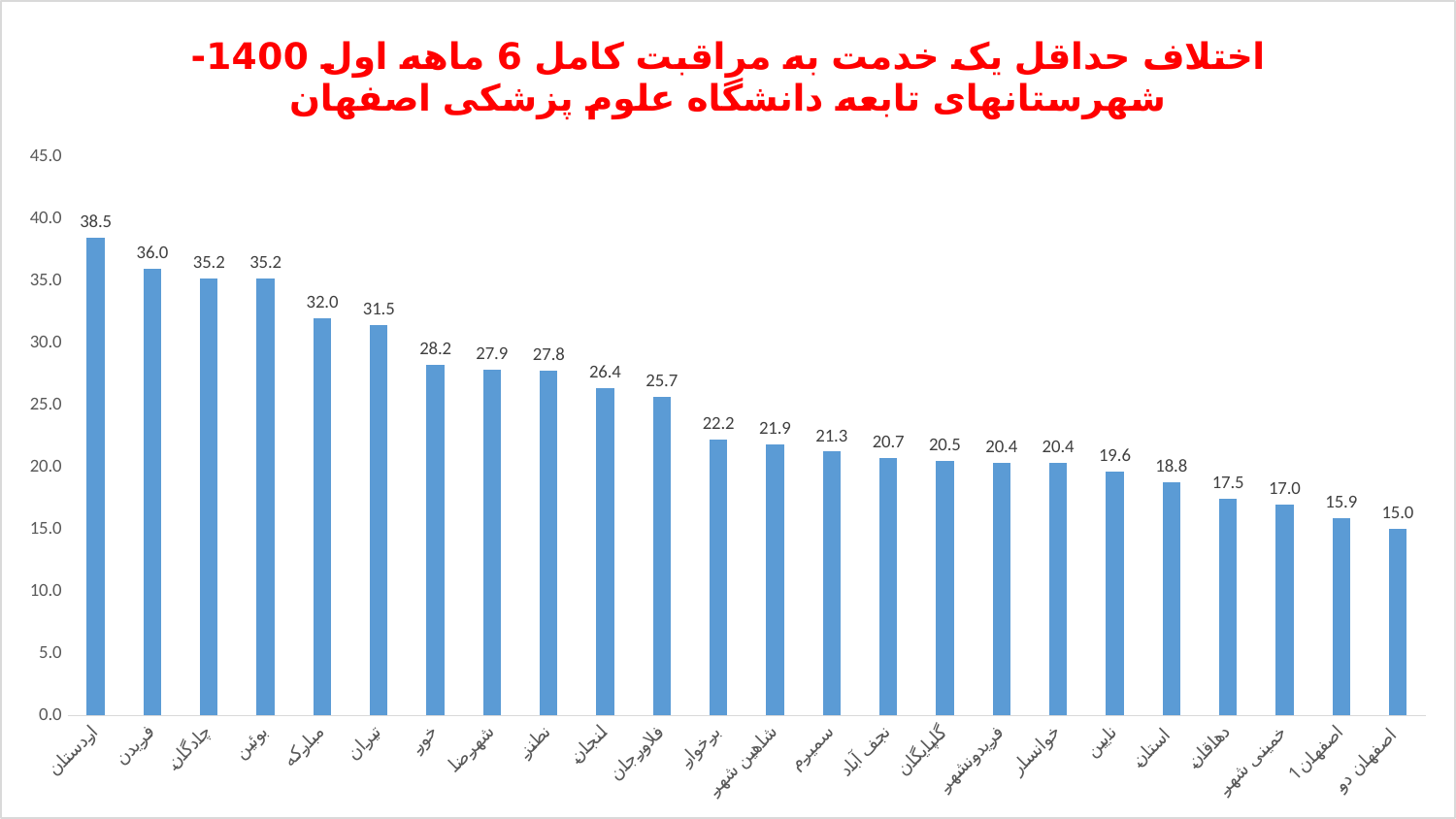
What type of chart is shown on the slide? bar chart Which category has the lowest value? اصفهان دو What is the value for شهرضا? 27.9 How many bars are plotted in the chart? 24 What is the difference between the values for اردستان and اصفهان دو? 23.5 Which category has the highest value? اردستان Do the values rise or fall moving from left to right along the x axis? fall What is the value for اردستان? 38.5 What is the value for استان? 18.8 Which has a larger value, مبارکه or برخوار? مبارکه What is the difference between the values for فریدن and تیران? 4.5 What is the value for نجف آباد? 20.7